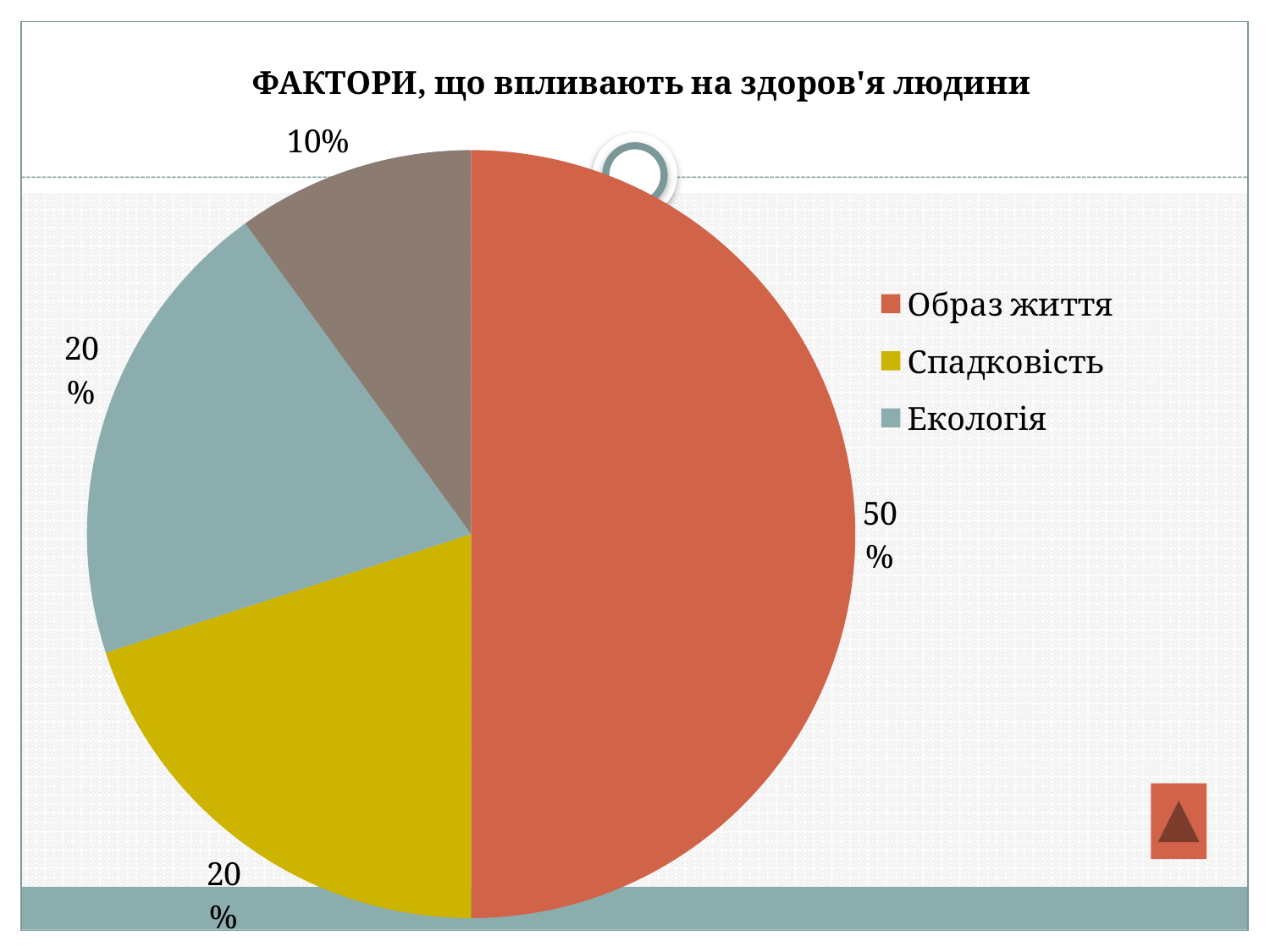
What percentage of the pie does Образ життя account for? 50% What percentage is shown for Спадковість? 20% What percentage is shown for Екологія? 20% Which category has the largest slice of the pie? Образ життя What is the smallest percentage labelled on the pie? 10% What is the title of the chart? ФАКТОРИ, що впливають на здоров'я людини How many slices does the pie chart have? 4 How many entries does the legend list? 3 Which is larger, the slice for Образ життя or the slice for Екологія? Образ життя What kind of chart is shown on the slide? pie chart By how many percentage points is Образ життя larger than Спадковість? 30 percentage points What colour is the slice for Спадковість in the legend? yellow